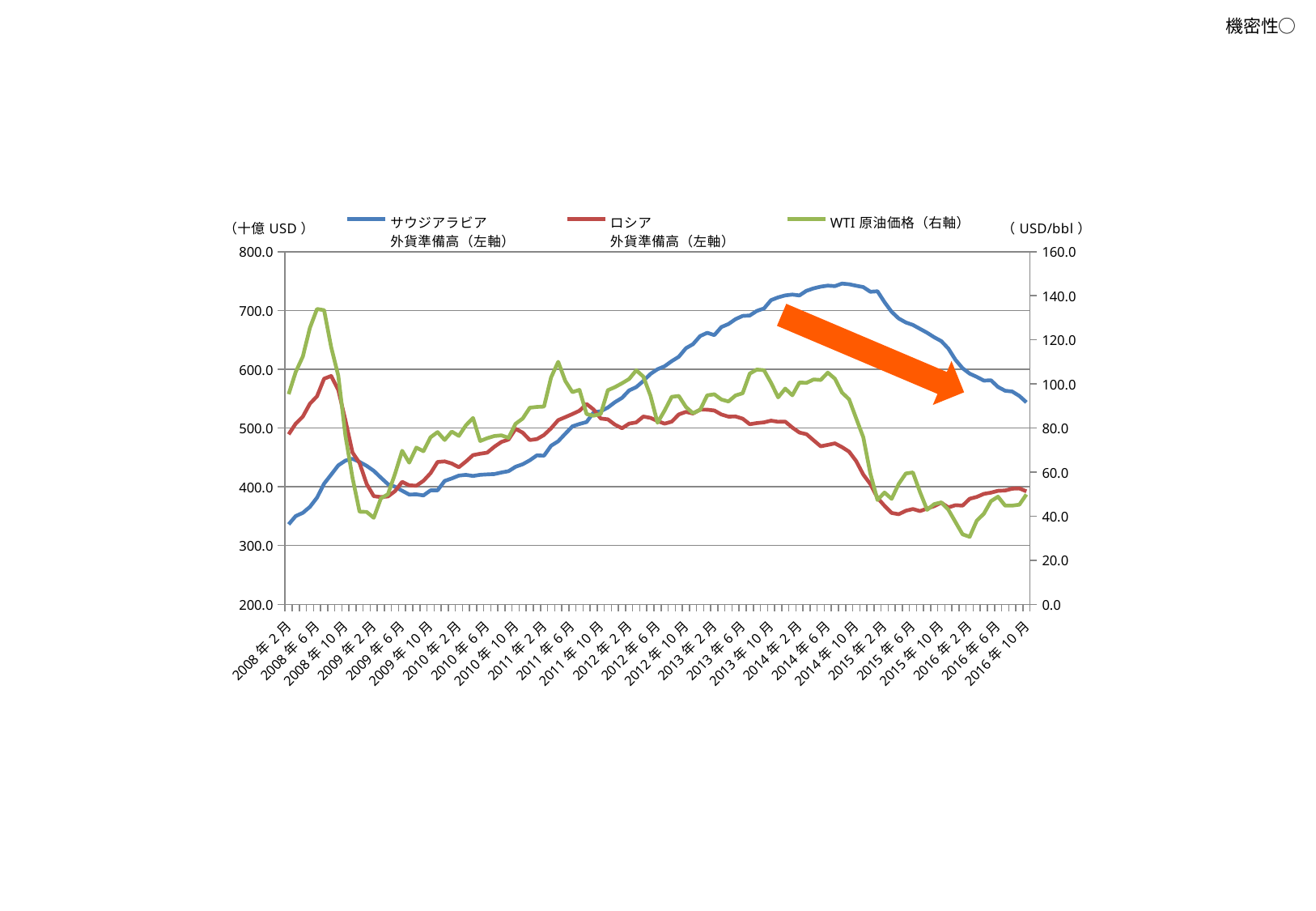
Is the value for ロシア外貨準備高 at 2015年6月 greater or less than 400? less At 2016年10月, which is larger: サウジアラビア外貨準備高 or ロシア外貨準備高? サウジアラビア外貨準備高 Is the WTI 原油価格 at 2016年2月 greater or less than 40? less Does the サウジアラビア外貨準備高 line rise or fall from 2014年10月 to 2016年10月? fall Is the value for サウジアラビア外貨準備高 at 2008年2月 greater or less than 400? less How many series does the legend list? 3 What kind of chart is shown on the slide? Line chart Which series is plotted against the right axis? WTI 原油価格 What unit is shown for the right axis? USD/bbl At 2008年2月, which is larger: サウジアラビア外貨準備高 or ロシア外貨準備高? ロシア外貨準備高